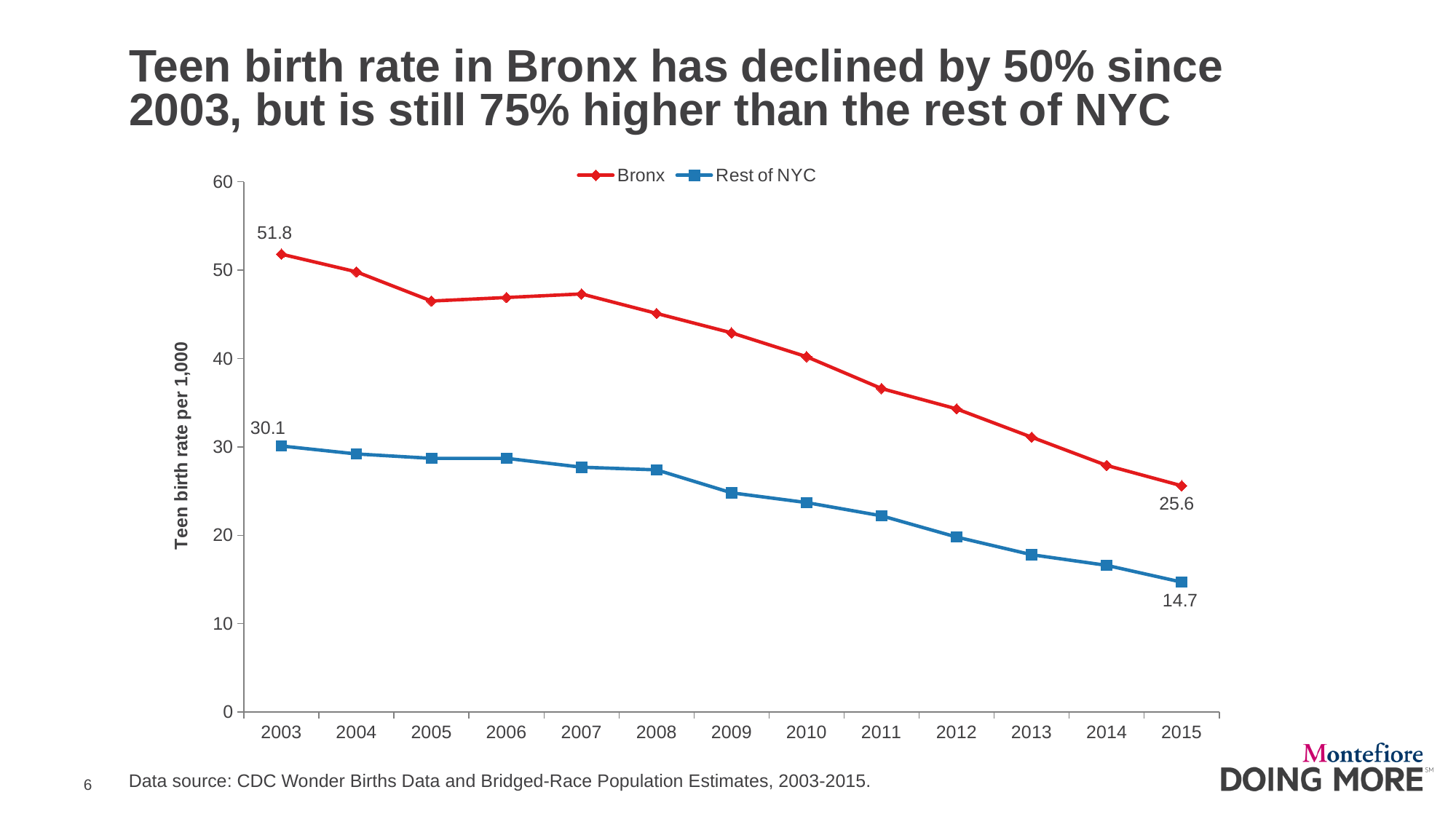
How many series does the legend list? 2 How many years are shown on the x axis? 13 By how much did the Bronx teen birth rate fall between 2003 and 2015? 26.2 What is the difference between the Bronx and Rest of NYC teen birth rates in 2015? 10.9 What was the Rest of NYC teen birth rate per 1,000 in 2015? 14.7 Is the Bronx teen birth rate in 2009 greater or less than 40? greater What was the Bronx teen birth rate per 1,000 in 2015? 25.6 Which series had the higher teen birth rate in 2010, Bronx or Rest of NYC? Bronx What was the Rest of NYC teen birth rate per 1,000 in 2003? 30.1 What kind of chart is shown on the slide? Line chart What was the Bronx teen birth rate per 1,000 in 2003? 51.8